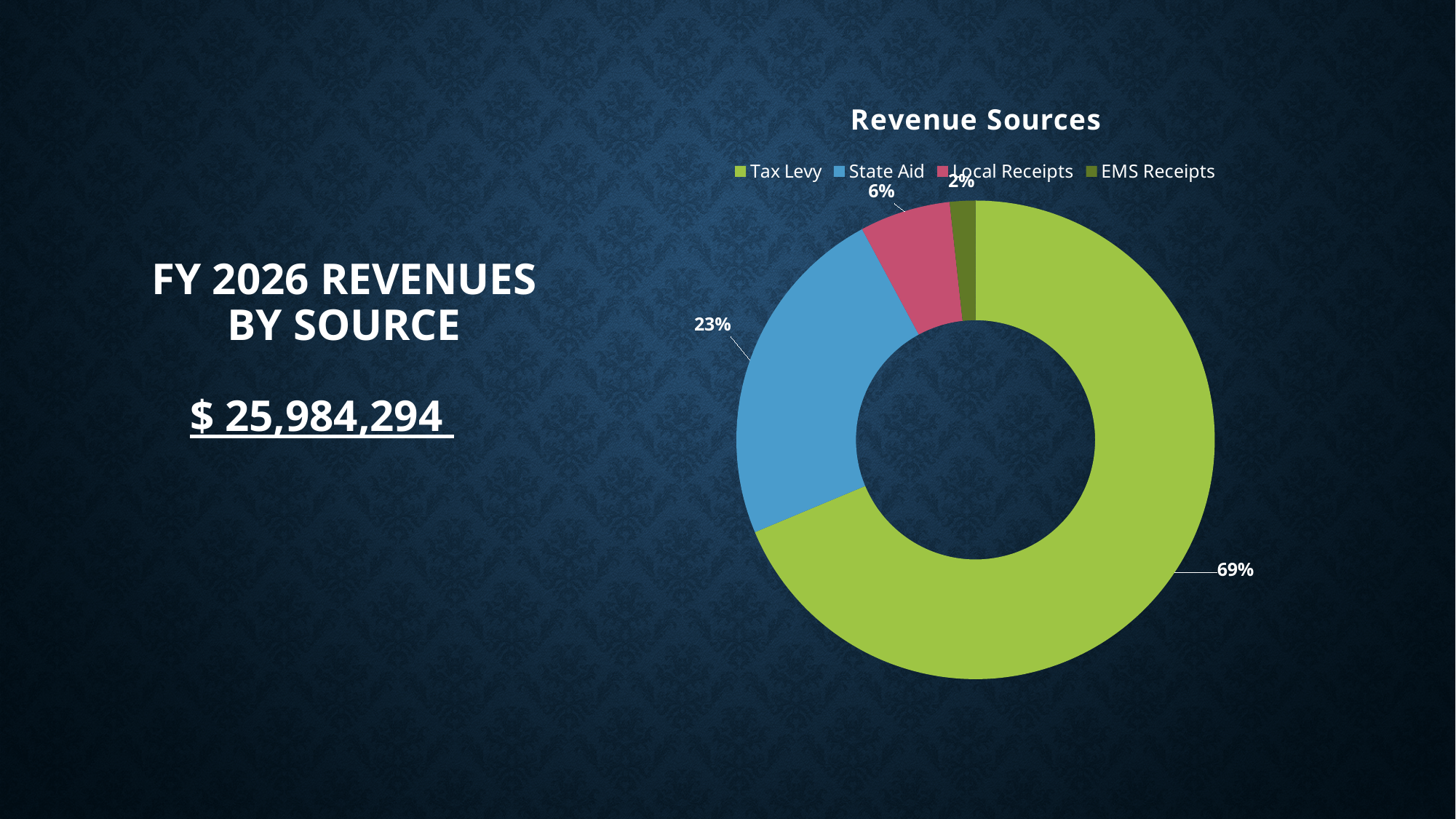
What is the title of the chart? Revenue Sources What kind of chart is used to show the revenue sources? Pie chart (doughnut) What share of revenue comes from Tax Levy? 69% How many revenue sources are shown in the chart? 4 What is the difference in percentage points between the Tax Levy share and the State Aid share? 46 Which revenue source has the smallest share? EMS Receipts What colour represents State Aid in the chart? Blue Which is larger, the State Aid share or the Local Receipts share? State Aid What share of revenue comes from State Aid? 23% What share of revenue comes from Local Receipts? 6% Which revenue source has the largest share? Tax Levy